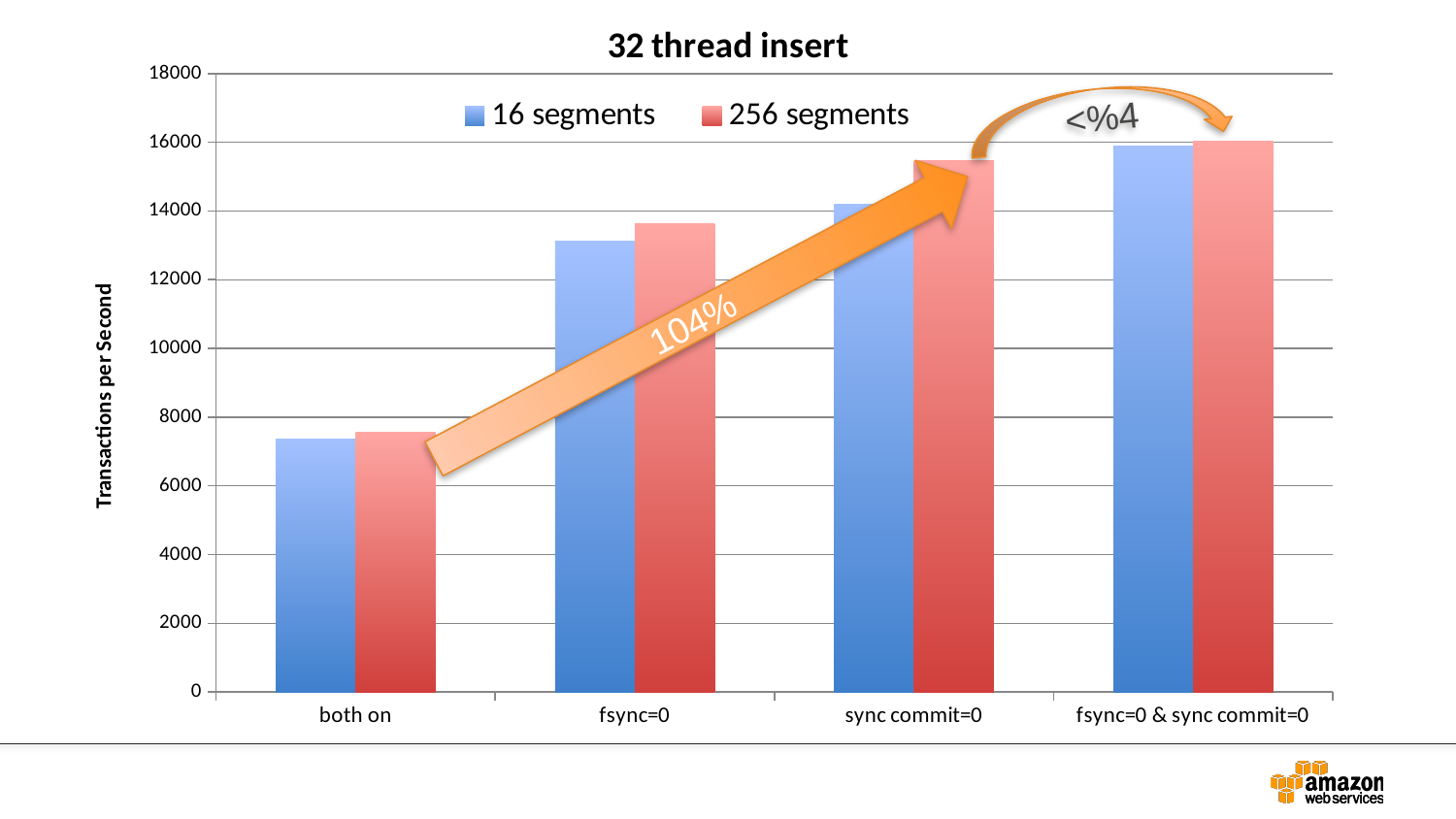
Is the value for 256 segments at 'sync commit=0' greater or less than 14000? greater How many series does the legend list? 2 Do the values for the 16 segments series rise or fall from left to right along the x axis? rise Which category has the highest value for the 256 segments series? fsync=0 & sync commit=0 What is the label of the vertical axis? Transactions per Second At 'sync commit=0', which series has the larger value, 16 segments or 256 segments? 256 segments What kind of chart is shown on the slide? bar chart Is the value for 16 segments at 'both on' greater or less than 8000? less Which category has the lowest value for the 16 segments series? both on Is the value for 256 segments at 'fsync=0' greater or less than 12000? greater What is the title of the chart? 32 thread insert How many categories are shown on the x axis? 4